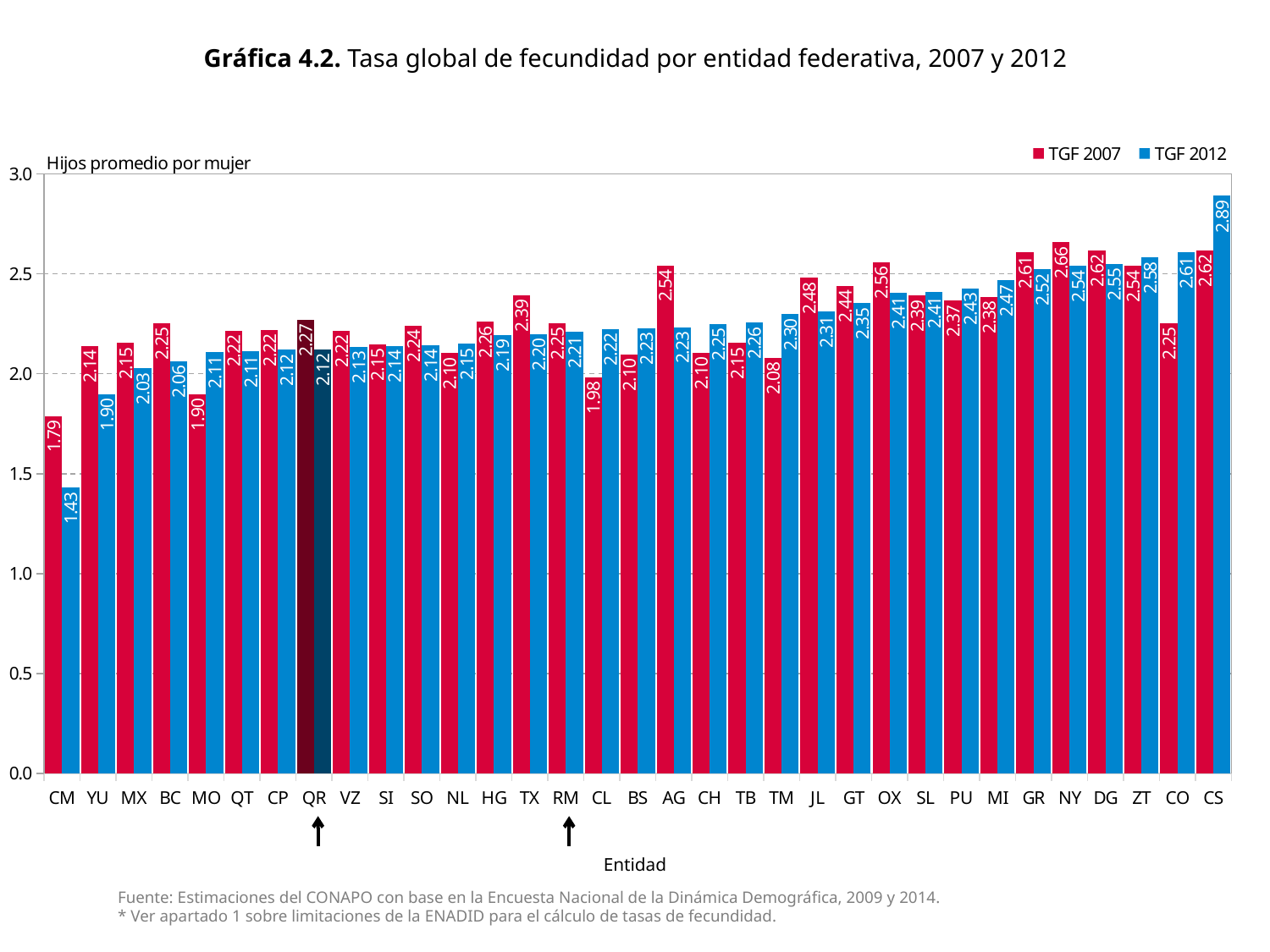
What is the difference between the TGF 2007 and TGF 2012 values for CM? 0.36 For CO, which is larger, the TGF 2007 value or the TGF 2012 value? TGF 2012 Do the TGF 2012 values generally rise or fall from left to right along the x axis? Rise What is the TGF 2012 value for QR? 2.12 What kind of chart is shown? Bar chart How many series does the legend list? 2 Which entity has the highest TGF 2007 value? NY Which entity has the lowest TGF 2012 value? CM What is the TGF 2012 value for CS? 2.89 What is the TGF 2007 value for CM? 1.79 How many entities are shown on the x axis? 33 Which entity has the highest TGF 2012 value? CS